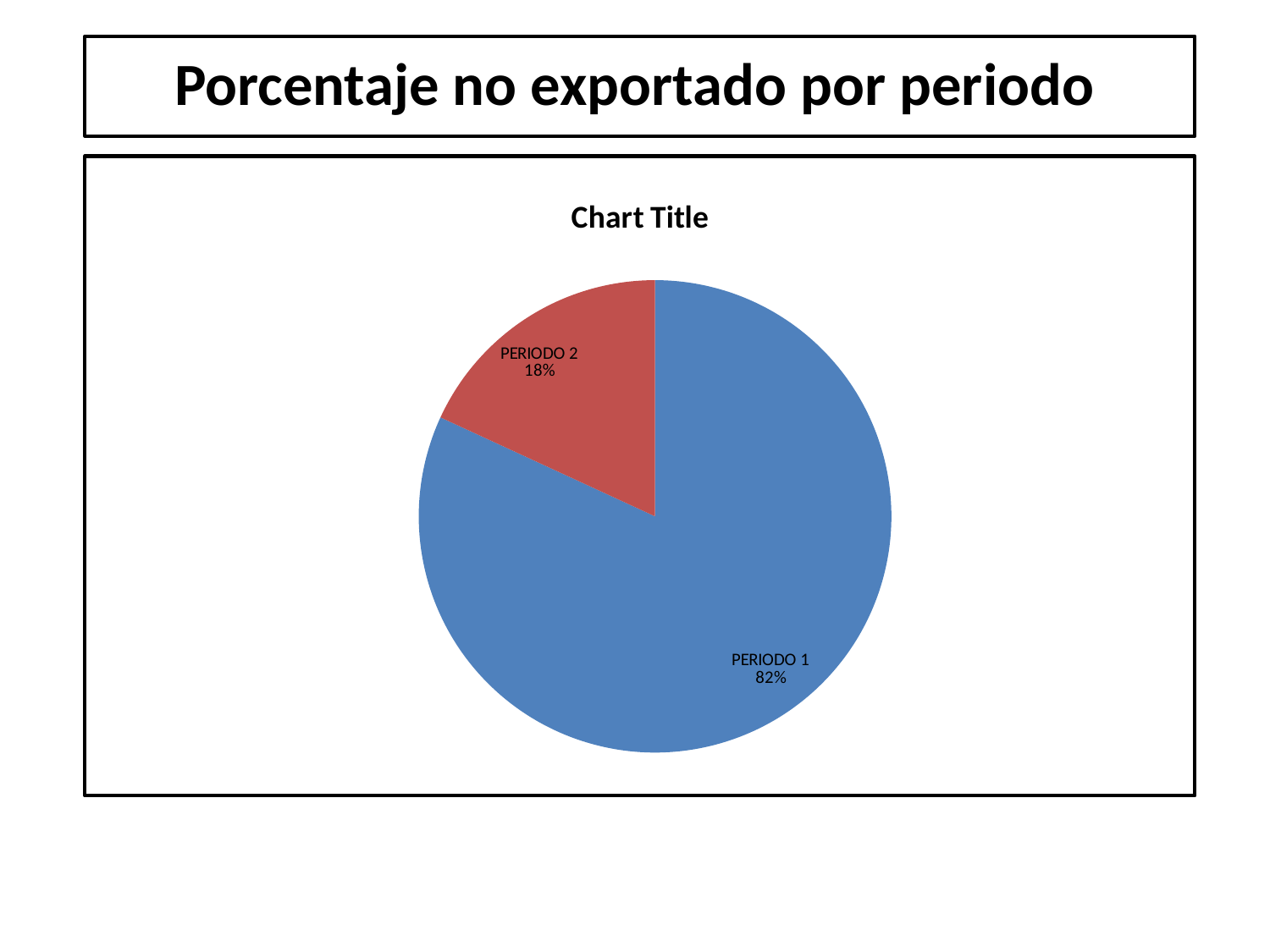
How many slices does the pie chart have? 2 What kind of chart is shown on the slide? pie chart What share of the pie does PERIODO 2 represent? 18% Which slice is the smallest in the pie chart? PERIODO 2 What share of the pie does PERIODO 1 represent? 82% Which is larger, the share for PERIODO 1 or PERIODO 2? PERIODO 1 Which slice is the largest in the pie chart? PERIODO 1 What colour is the PERIODO 2 slice? red What is the title shown above the pie chart? Chart Title What is the difference in percentage points between the PERIODO 1 and PERIODO 2 slices? 64